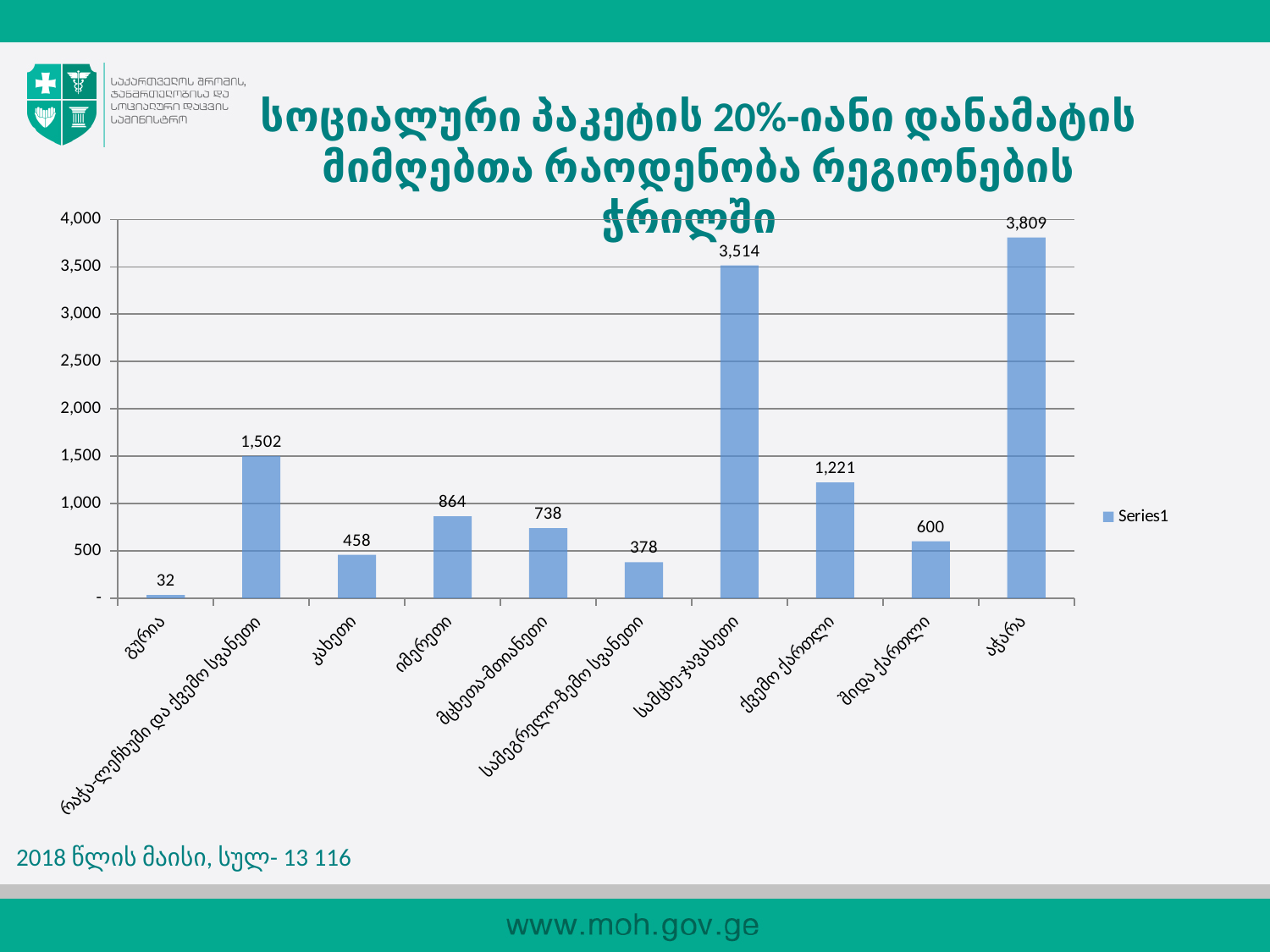
How many categories are shown on the x axis? 10 Which category has the lowest value? გურია What is the value for სამცხე-ჯავახეთი? 3,514 What is the difference between the values for აჭარა and სამცხე-ჯავახეთი? 295 What is the value for გურია? 32 What is the value for ქვემო ქართლი? 1,221 What kind of chart is shown on the slide? bar chart What is the legend entry shown on the chart? Series1 Which category has the highest value? აჭარა How many series does the legend list? 1 Which is larger, the value for იმერეთი or the value for მცხეთა-მთიანეთი? იმერეთი Is the value for რაჭა-ლეჩხუმი და ქვემო სვანეთი greater or less than 1,000? greater